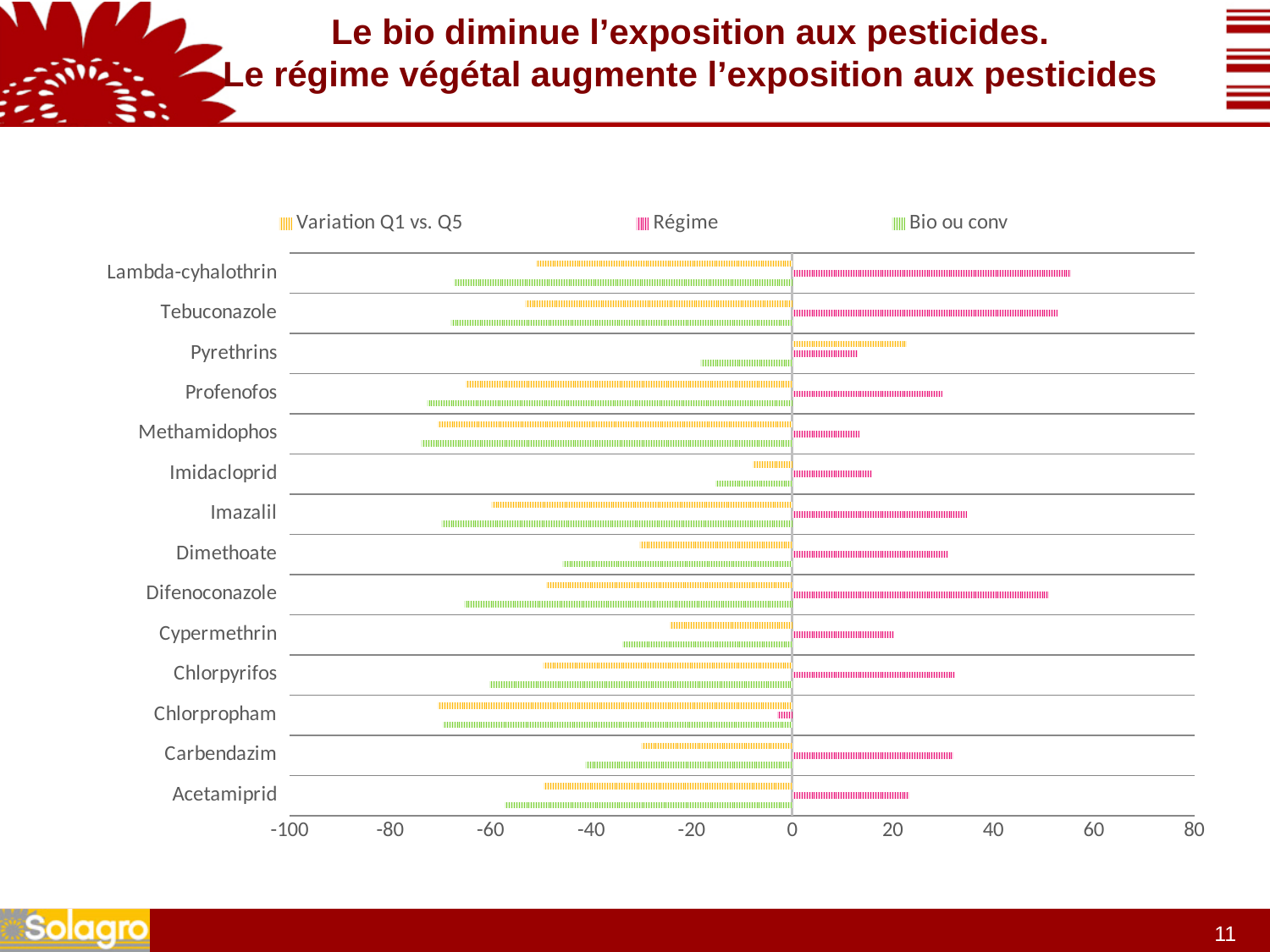
What kind of chart is shown on the slide? bar chart Which category has the lowest value for the Régime series? Chlorpropham What are the three series named in the chart legend? Variation Q1 vs. Q5, Régime, Bio ou conv How many pesticide categories are listed on the vertical axis of the chart? 14 Which category has the highest value for the Variation Q1 vs. Q5 series? Pyrethrins Is the Régime value for Pyrethrins greater or less than 20? less How many series does the chart legend list? 3 Which has the larger Régime value, Lambda-cyhalothrin or Methamidophos? Lambda-cyhalothrin Is the Régime value for Lambda-cyhalothrin greater or less than 40? greater Is the Bio ou conv value for Chlorpropham greater or less than -60? less Which has the larger Bio ou conv value, Pyrethrins or Profenofos? Pyrethrins